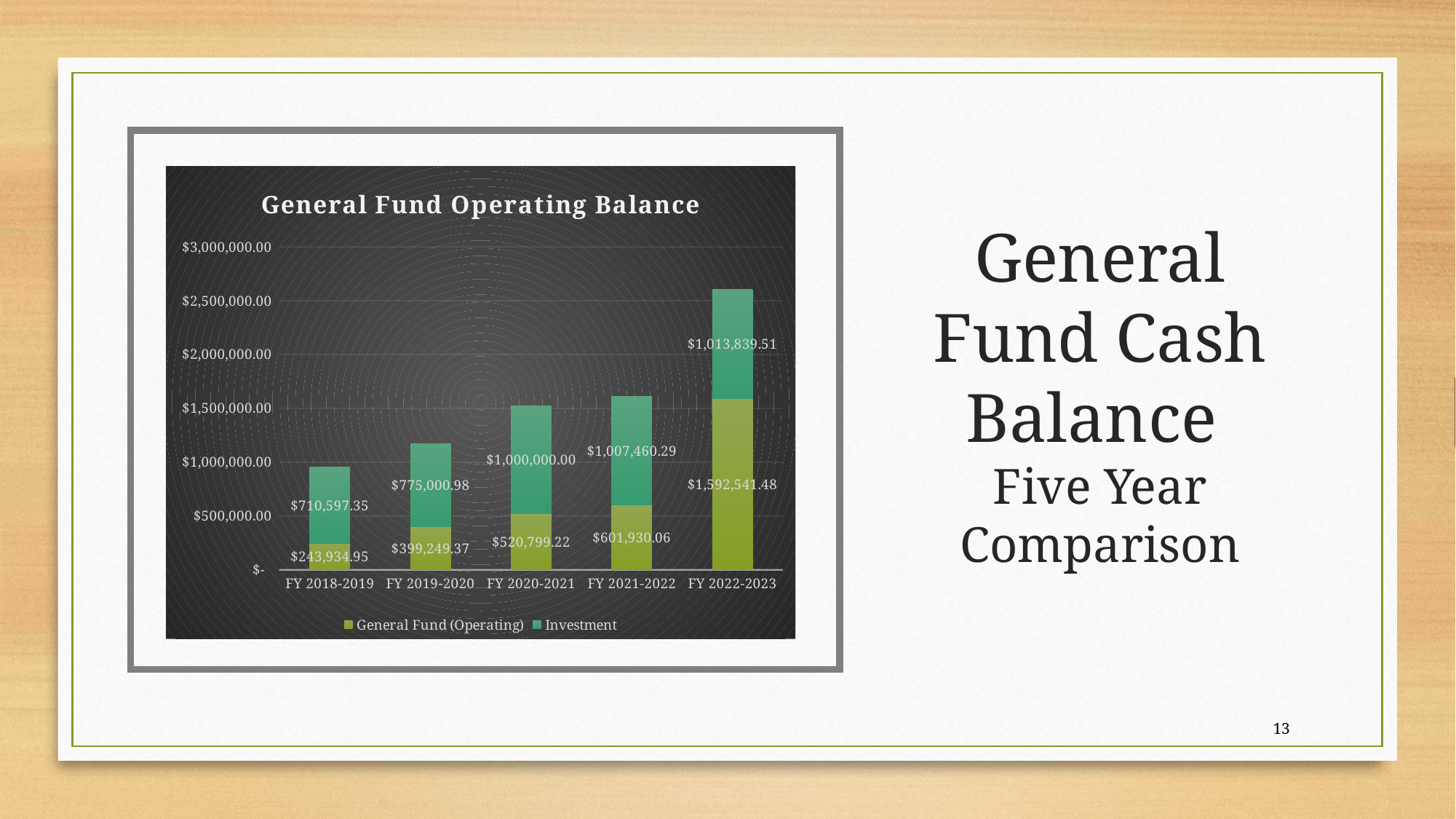
What is the General Fund (Operating) value for FY 2018-2019? $243,934.95 How many series does the legend list? 2 What is the difference between the General Fund (Operating) values for FY 2022-2023 and FY 2021-2022? $990,611.42 What is the General Fund (Operating) value for FY 2022-2023? $1,592,541.48 What is the total of the stacked bar for FY 2018-2019? $954,532.30 Does the General Fund (Operating) value rise or fall from FY 2018-2019 to FY 2022-2023? Rise What is the title of the chart? General Fund Operating Balance How many fiscal years are shown on the x axis? 5 Which fiscal year has the lowest Investment value? FY 2018-2019 What is the Investment value for FY 2020-2021? $1,000,000.00 What kind of chart is shown on the slide? Stacked bar chart Which fiscal year has the highest General Fund (Operating) value? FY 2022-2023